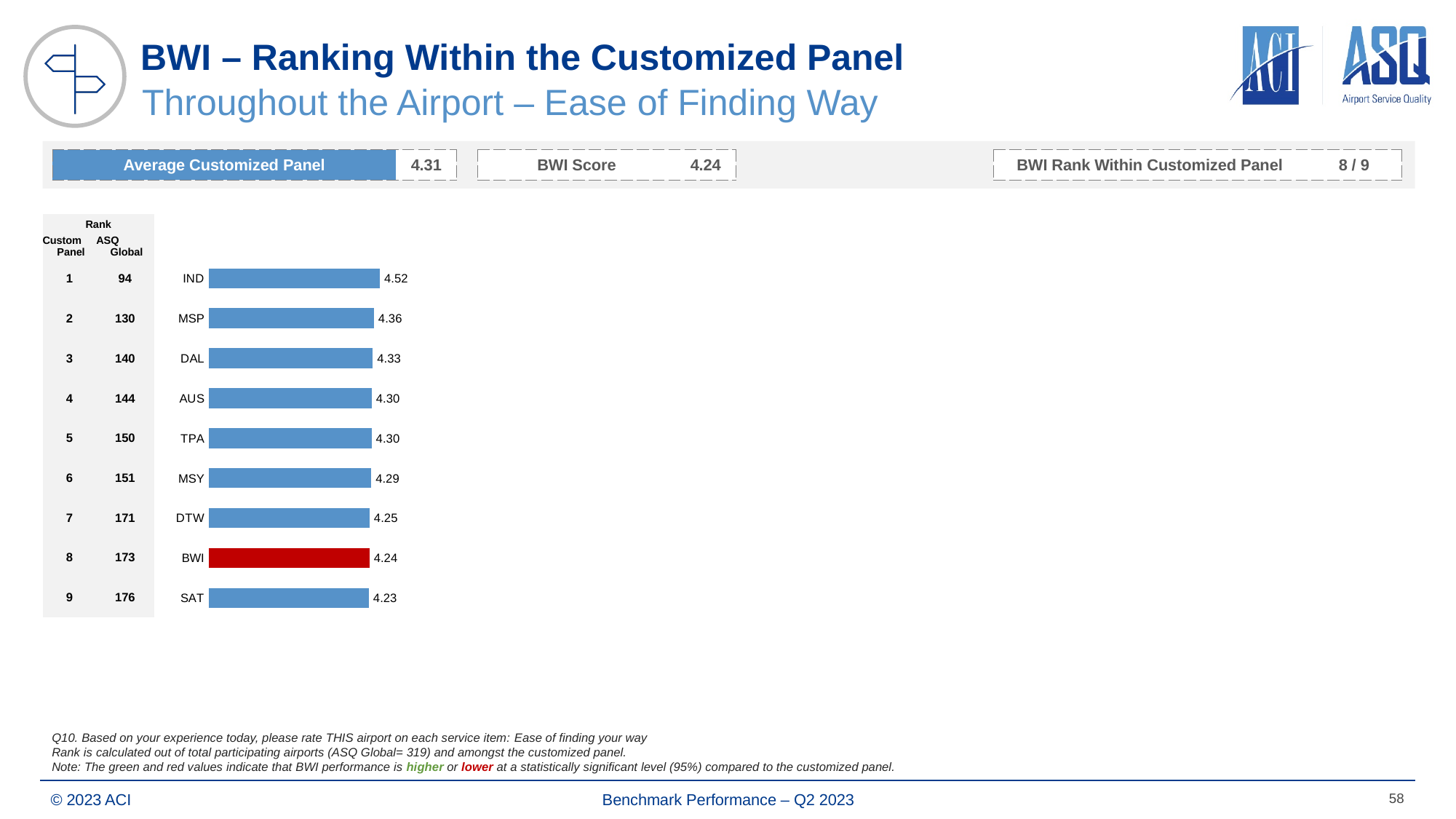
How many airports are shown in the chart? 9 Which airport has the highest value? IND What is the value for IND? 4.52 Which airport has the lowest value? SAT What is the difference between the values for MSP and SAT? 0.13 Which bar is coloured red? BWI What is the value for BWI? 4.24 Which has a larger value, MSP or DAL? MSP What is the difference between the values for IND and BWI? 0.28 What is the value for MSY? 4.29 What is the value for DTW? 4.25 What kind of chart is shown? Bar chart